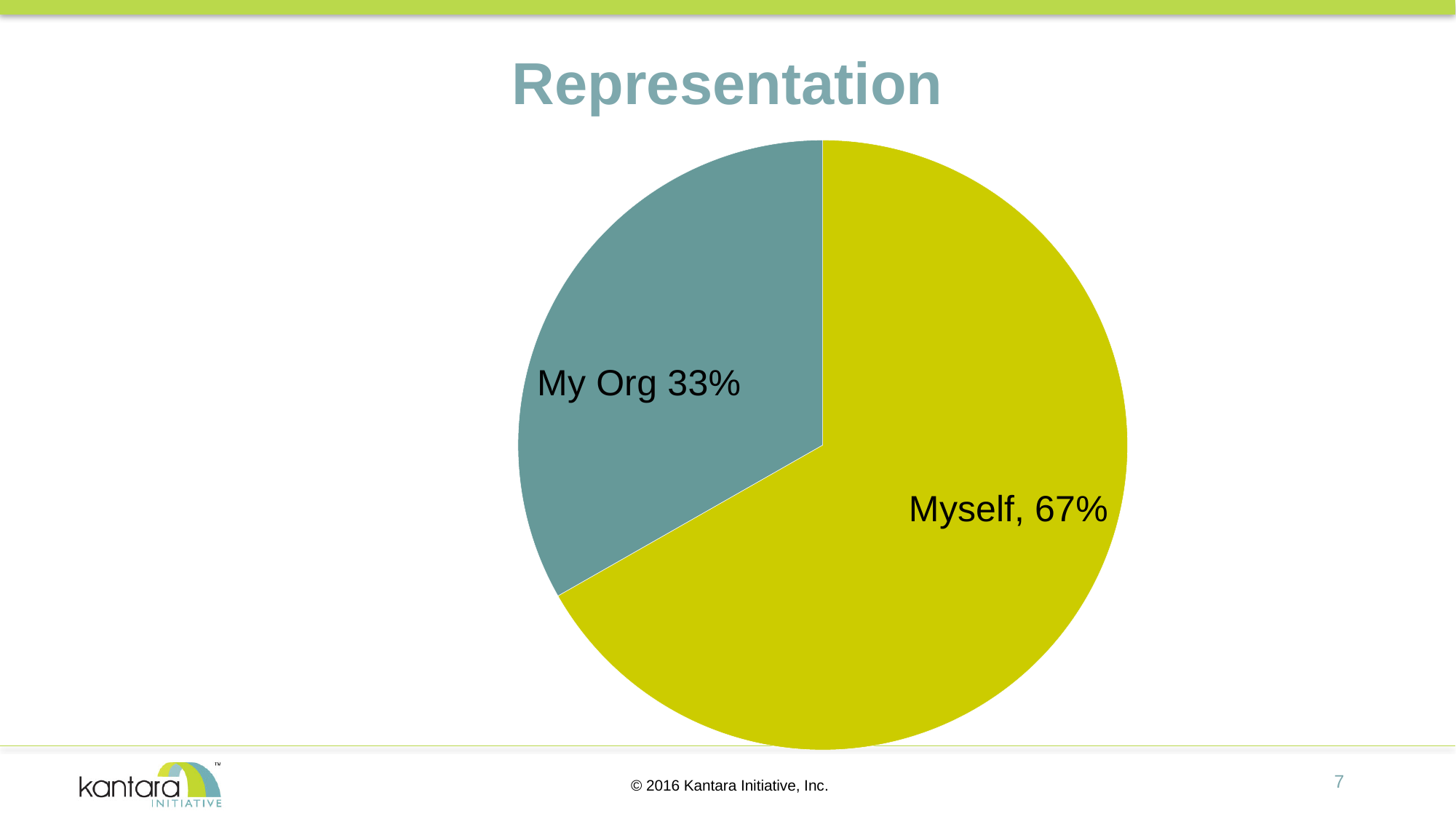
How many slices does the pie chart have? 2 What is the title of the chart? Representation What share of the pie does the My Org slice represent? 33% What share of the pie does the Myself slice represent? 67% What colour is the Myself slice? yellow-green Which is larger, the Myself slice or the My Org slice? Myself Which slice is the smallest? My Org What kind of chart is shown on the slide? pie chart What is the difference in percentage points between the Myself and My Org slices? 34 Which slice is the largest? Myself